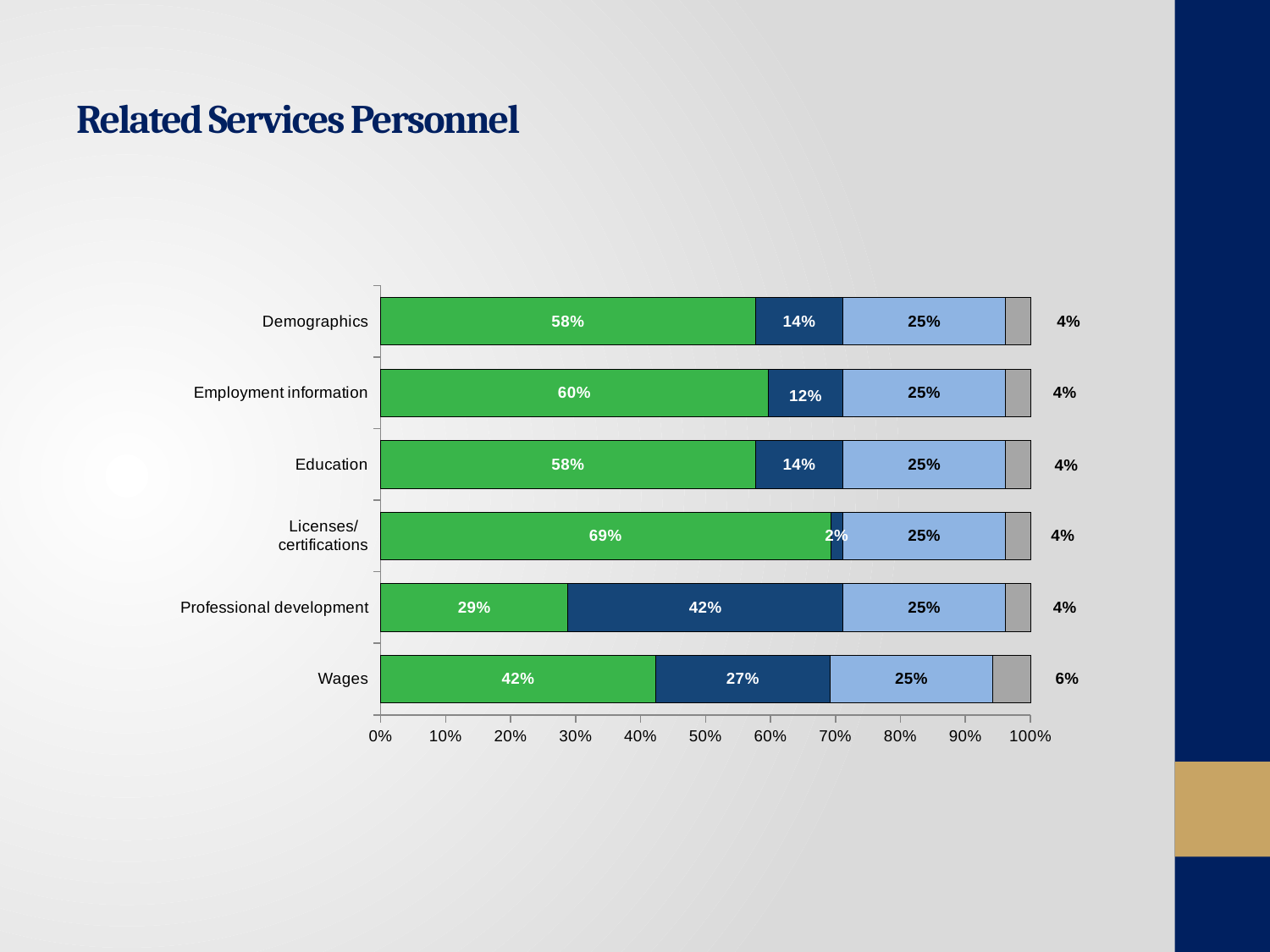
Which is larger: the dark blue segment for Wages or the dark blue segment for Education? Wages What is the value of the light blue segment for Demographics? 25% What is the title of the slide containing the chart? Related Services Personnel What kind of chart is shown on the slide? Stacked bar chart What is the value of the dark blue segment for Employment information? 12% Which category has the largest green segment? Licenses/certifications Which category has the smallest green segment? Professional development How many categories are plotted on the chart? 6 What is the value of the green segment for Licenses/certifications? 69% What is the value of the grey segment for Wages? 6% What is the value of the dark blue segment for Professional development? 42% What is the difference between the green segment for Employment information and the green segment for Professional development? 31%